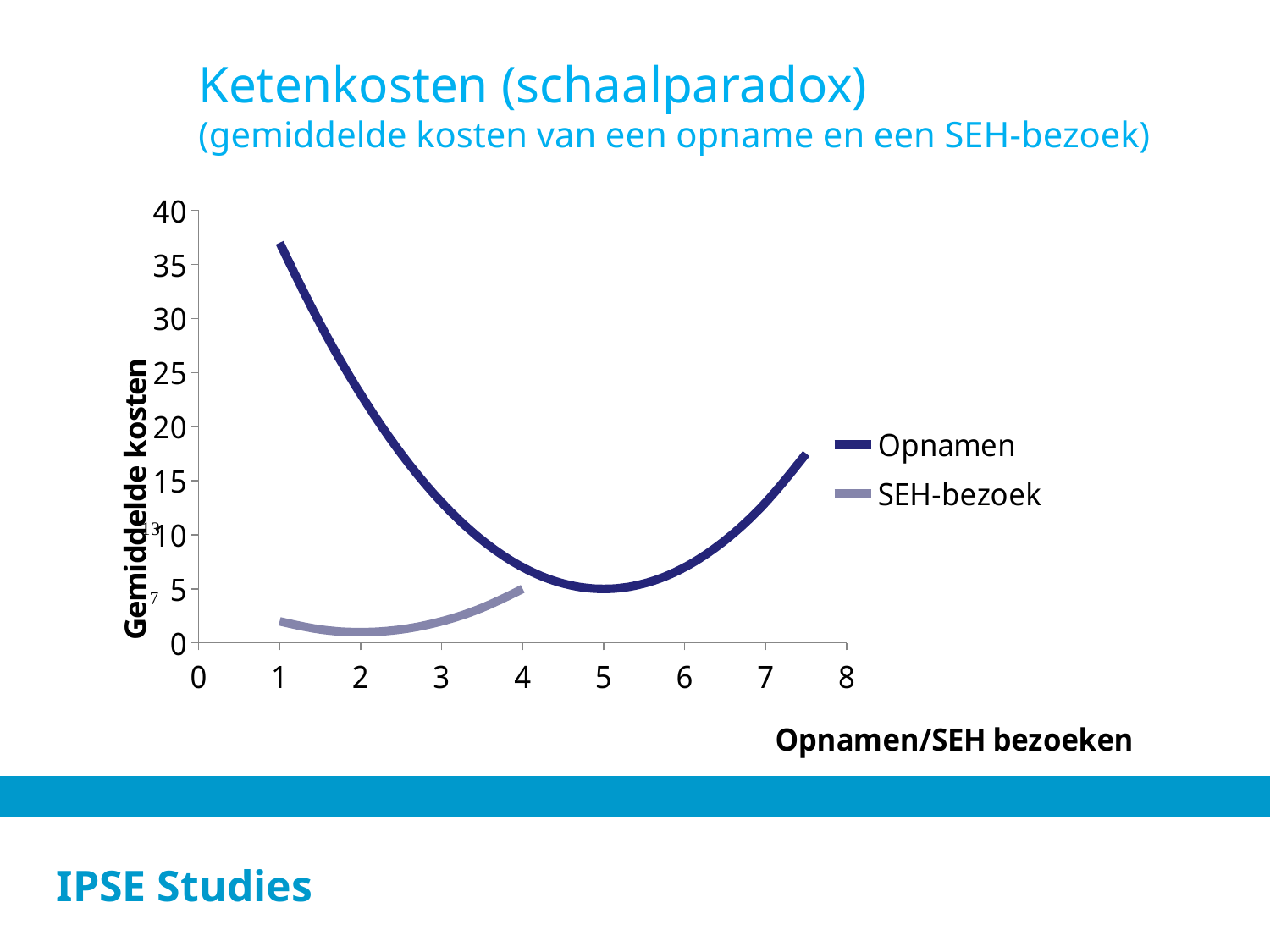
At which x value does the Opnamen curve reach its lowest point? 5 At x = 1, which series has the higher value, Opnamen or SEH-bezoek? Opnamen Is the value of the Opnamen curve at x = 5 greater or less than 10? less What kind of chart is shown on the slide? line chart Does the Opnamen curve rise or fall between x = 1 and x = 5? fall Is the value of the Opnamen curve at x = 1 greater or less than 35? greater Is the value of the SEH-bezoek curve at x = 1 greater or less than 5? less What is the label of the vertical axis? Gemiddelde kosten How many series does the legend list? 2 What are the two series named in the legend? Opnamen and SEH-bezoek